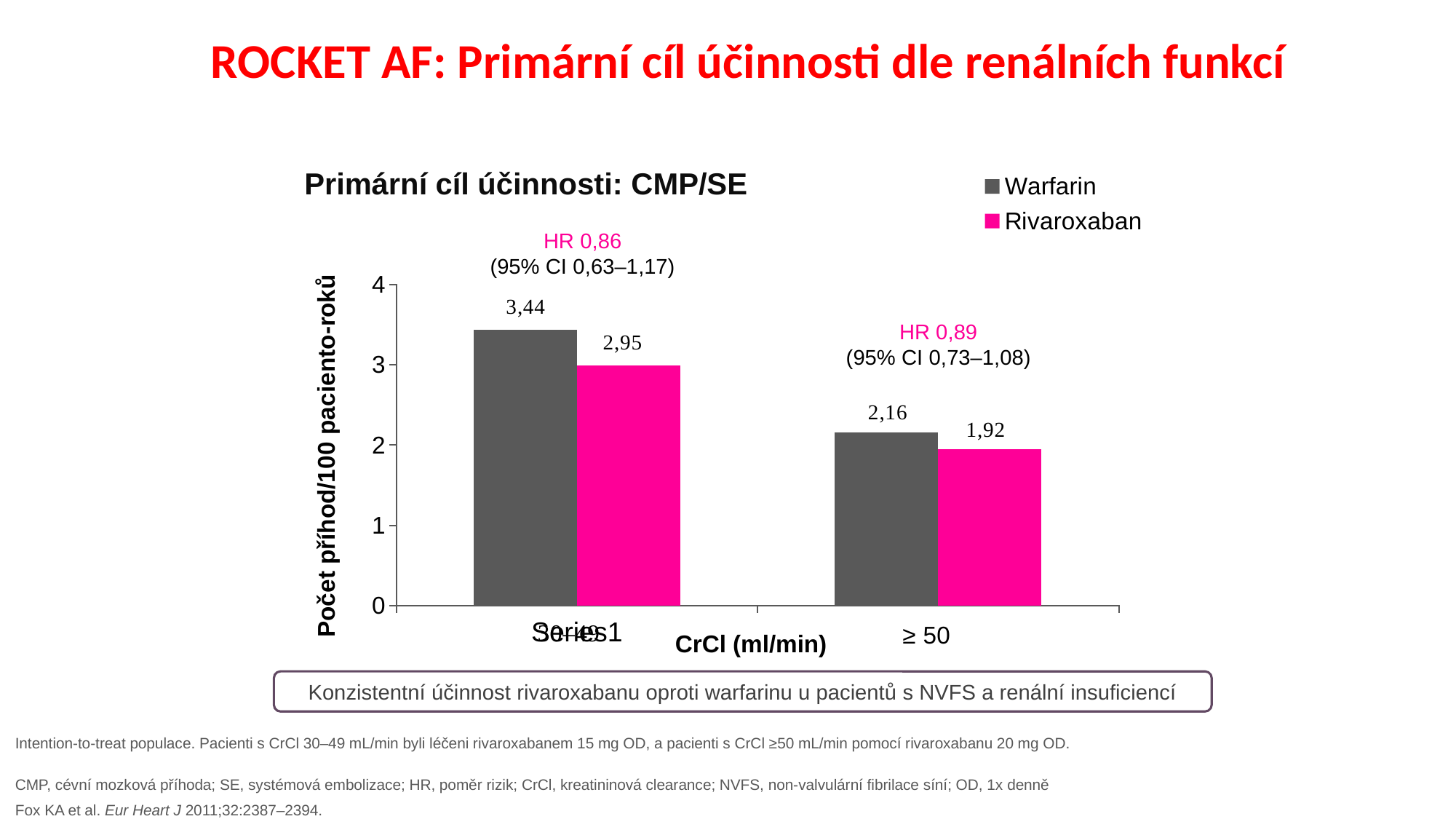
How many series does the legend list? 2 What hazard ratio (HR) is shown above the CrCl ≥ 50 group? HR 0,89 What is the value for Rivaroxaban in the left-hand CrCl group? 2,95 What is the value for Rivaroxaban in the CrCl ≥ 50 group? 1,92 What is the value for Warfarin in the left-hand CrCl group? 3,44 In the CrCl ≥ 50 group, which is larger: the Warfarin value or the Rivaroxaban value? Warfarin Which bar has the highest value on the chart? Warfarin in the left-hand CrCl group (3,44) What kind of chart is shown on the slide? Bar chart What is the value for Warfarin in the CrCl ≥ 50 group? 2,16 What is the difference between the Warfarin and Rivaroxaban values in the CrCl ≥ 50 group? 0,24 What is the difference between the Warfarin and Rivaroxaban values in the left-hand CrCl group? 0,49 Which bar has the lowest value on the chart? Rivaroxaban in the CrCl ≥ 50 group (1,92)